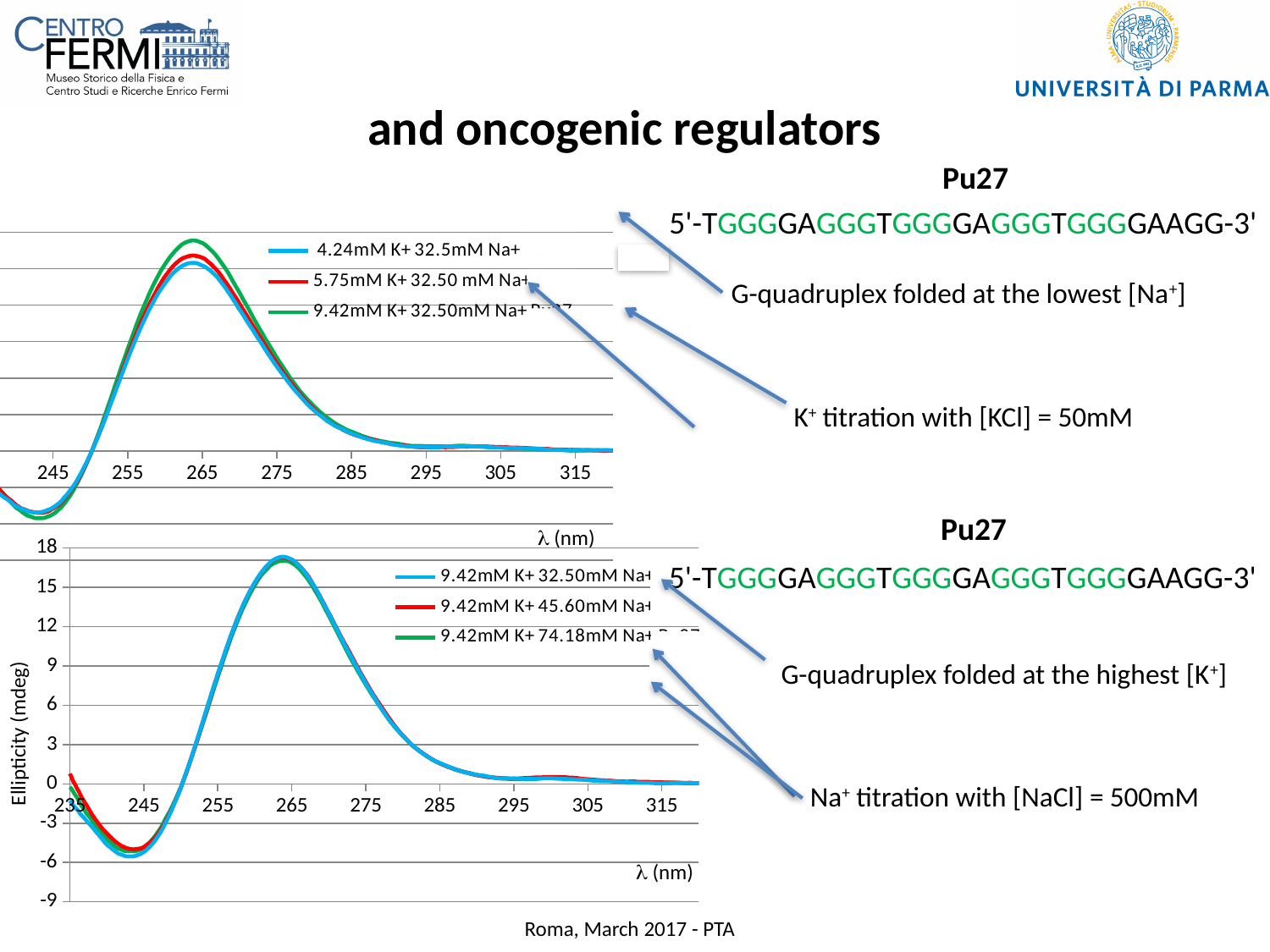
In the bottom chart, do the curves rise or fall between 265 nm and 285 nm? fall In the bottom chart, is the ellipticity at 305 nm greater or less than 3? less In the top chart, which series reaches the highest peak near 265 nm? 9.42mM K+ 32.50mM Na+ In the bottom chart, which colour is used for the 9.42mM K+ 45.60mM Na+ series? red What is the y-axis label of the bottom chart? Ellipticity (mdeg) How many series does the legend of the top chart list? 3 In the bottom chart, is the minimum ellipticity near 245 nm greater or less than -3? less In the bottom chart, do the curves rise or fall between 245 nm and 265 nm? rise How many series does the legend of the bottom chart list? 3 In the bottom chart, is the peak ellipticity near 265 nm greater or less than 15? greater What kind of chart is the bottom chart on the slide? line chart